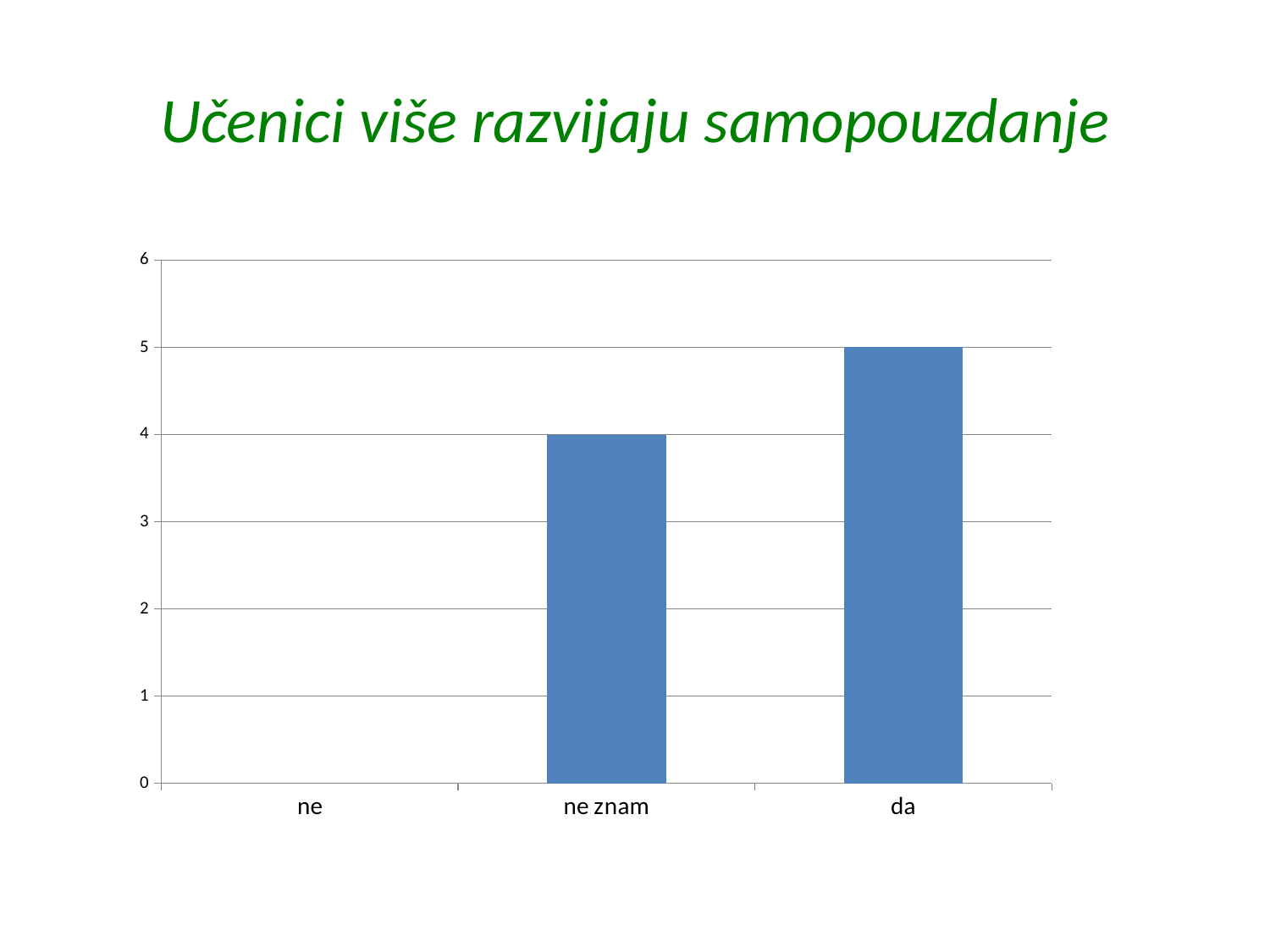
Do the values rise or fall from left to right along the x axis? rise How many categories are shown on the x axis? 3 What type of chart is shown on the slide? bar chart Which category has the lowest value? ne What is the difference between the values for "da" and "ne znam"? 1 Which is larger, the value for "ne znam" or the value for "da"? da Which category has the highest value? da What is the value for "ne znam"? 4 Is the value for "da" greater or less than 3? greater What is the value for "da"? 5 What is the value for "ne"? 0 What is the title of the slide? Učenici više razvijaju samopouzdanje